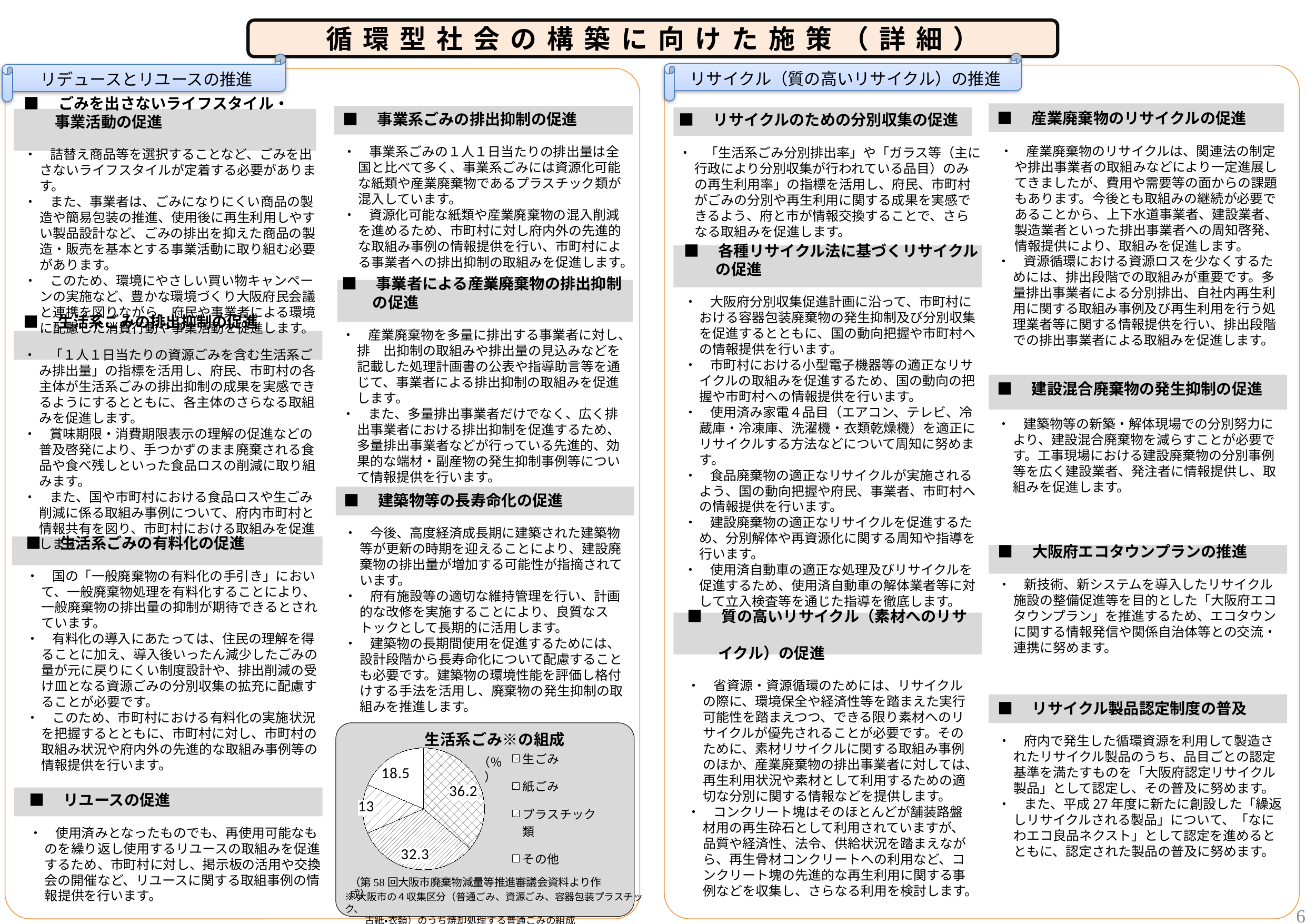
In the 生活系ごみ※の組成 pie chart, which is larger, その他 or プラスチック類? その他 Which category has the largest slice in the 生活系ごみ※の組成 pie chart? 生ごみ In the 生活系ごみ※の組成 pie chart, what is the difference between the values for 生ごみ and 紙ごみ? 3.9 In the 生活系ごみ※の組成 pie chart, what is the value for 生ごみ? 36.2 How many slices does the 生活系ごみ※の組成 pie chart have? 4 In the 生活系ごみ※の組成 pie chart, what is the value for その他? 18.5 How many entries does the legend of the 生活系ごみ※の組成 pie chart list? 4 In the 生活系ごみ※の組成 pie chart, what is the value for 紙ごみ? 32.3 What kind of chart is shown under the title 生活系ごみ※の組成? pie chart In the 生活系ごみ※の組成 pie chart, what is the value for プラスチック類? 13 Which category has the smallest slice in the 生活系ごみ※の組成 pie chart? プラスチック類 What unit is indicated next to the 生活系ごみ※の組成 pie chart? %